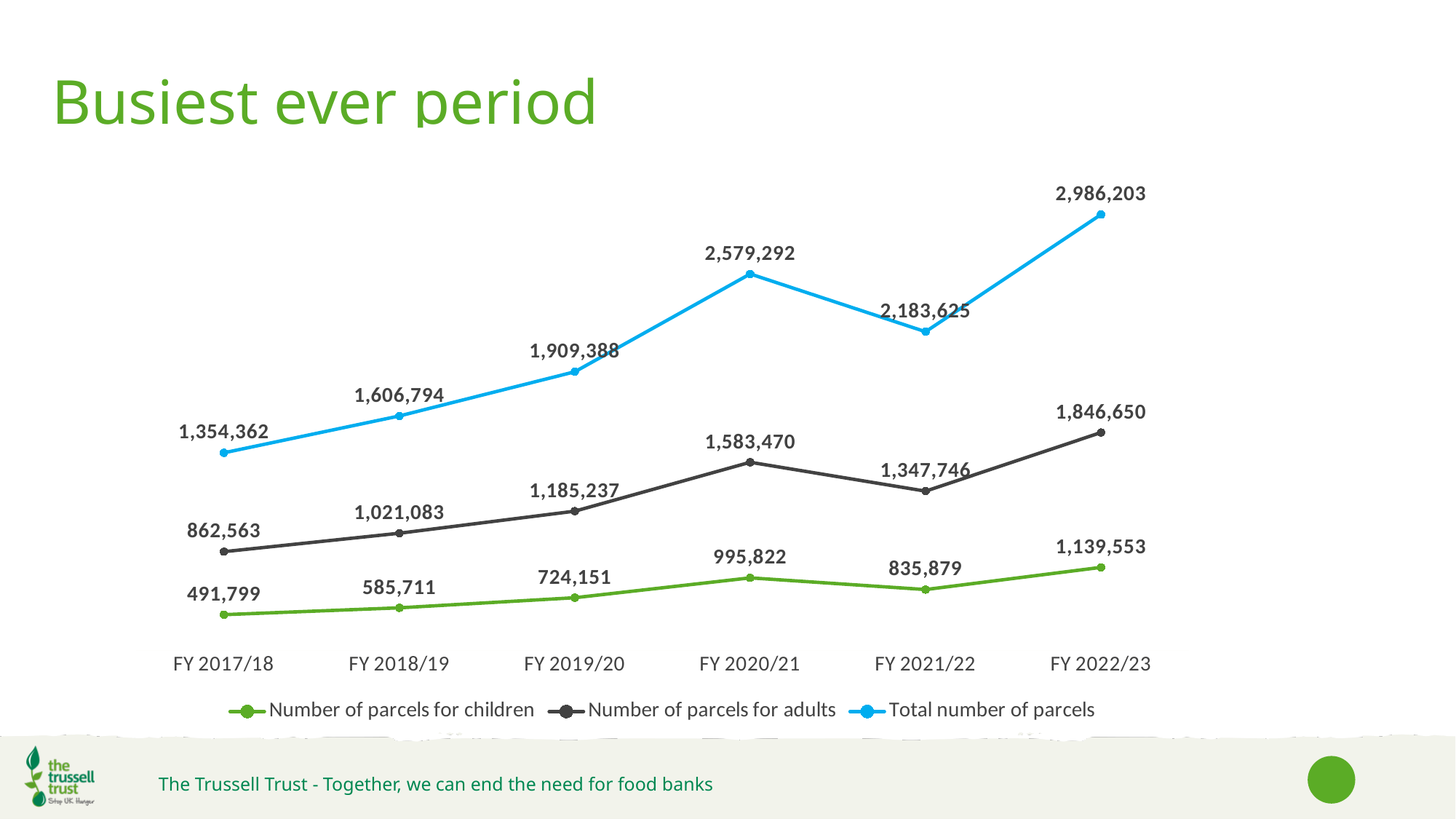
Which is larger: the number of parcels for adults in FY 2020/21 or the total number of parcels in FY 2017/18? Number of parcels for adults in FY 2020/21 How many financial years are plotted on the x axis? 6 What is the number of parcels for children in FY 2019/20? 724,151 How many series does the legend list? 3 Does the number of parcels for children rise or fall from FY 2017/18 to FY 2020/21? rise What is the total number of parcels in FY 2022/23? 2,986,203 What is the number of parcels for adults in FY 2021/22? 1,347,746 What type of chart is shown on the slide? line chart What is the difference between the total number of parcels in FY 2022/23 and FY 2021/22? 802,578 By how much does the number of parcels for children fall from FY 2020/21 to FY 2021/22? 159,943 In which financial year is the total number of parcels highest? FY 2022/23 In which financial year is the number of parcels for children lowest? FY 2017/18